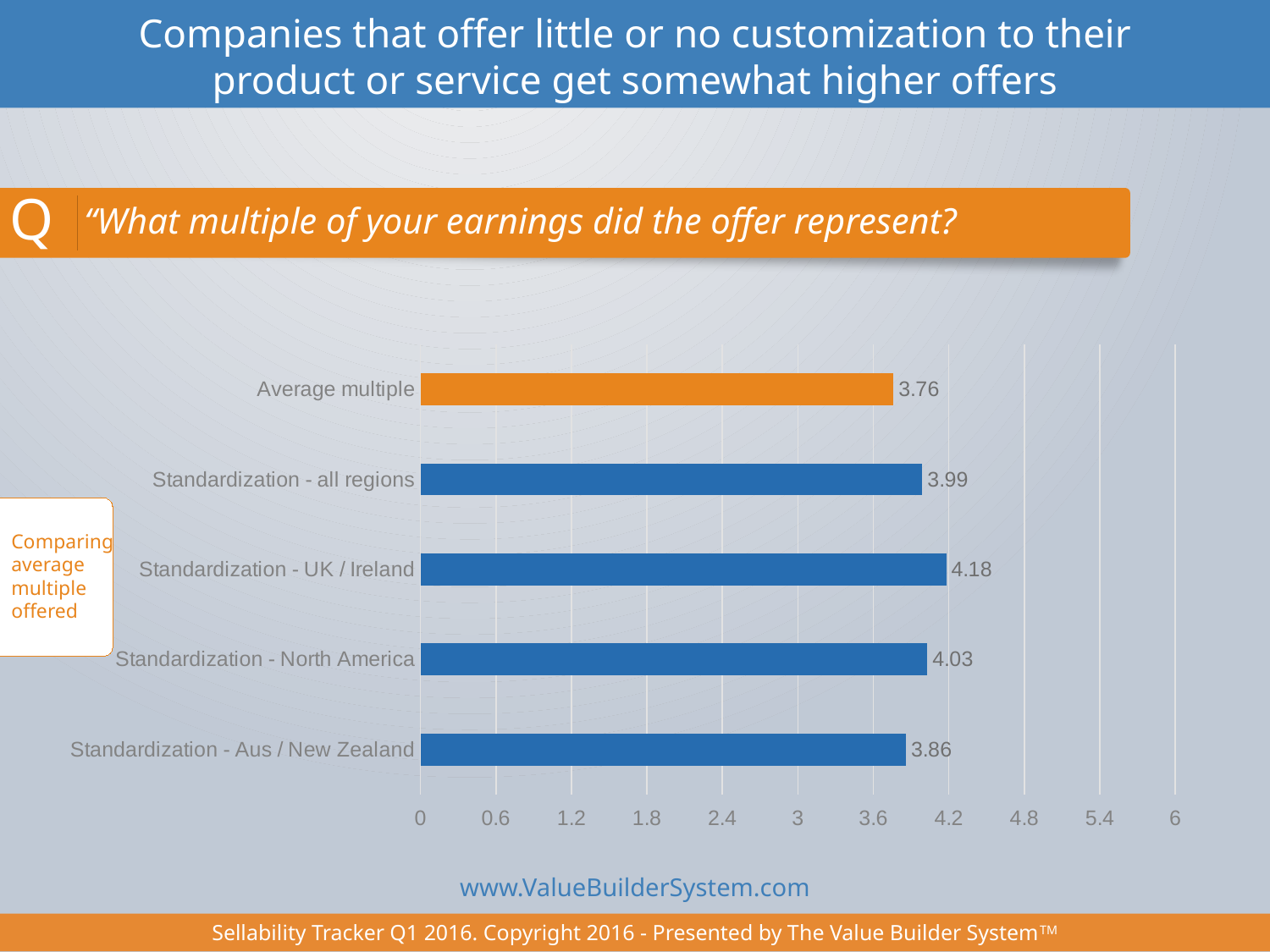
What is the value for Standardization - North America? 4.03 What kind of chart is shown on the slide? Bar chart What is the value for Standardization - UK / Ireland? 4.18 What is the value for Standardization - Aus / New Zealand? 3.86 What is the value for Average multiple? 3.76 Which category has the lowest value? Average multiple Which is larger, Standardization - all regions or Standardization - North America? Standardization - North America What is the difference between Standardization - UK / Ireland and Average multiple? 0.42 Which bar is coloured orange rather than blue? Average multiple How many categories are shown in the chart? 5 Which category has the highest value? Standardization - UK / Ireland Is the value for Standardization - all regions greater or less than 3.6? greater